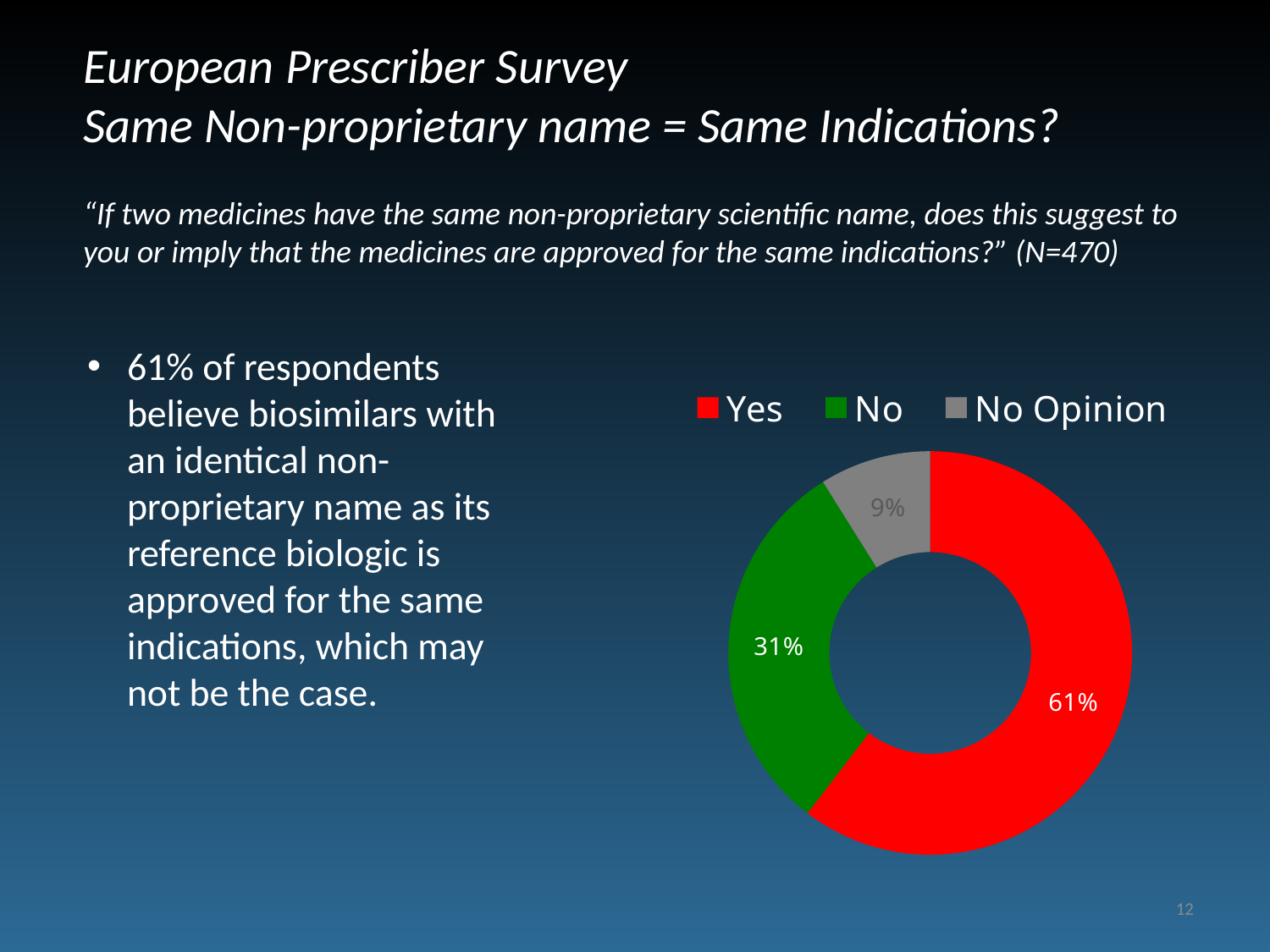
What type of chart is shown on the slide? Doughnut chart What is the difference in percentage points between the "No" and "No Opinion" shares? 22 Which is larger, the share for "No" or the share for "No Opinion"? No What is the difference in percentage points between the "Yes" and "No" shares? 30 What colour represents the "Yes" category in the chart? Red What percentage of respondents had "No Opinion" according to the chart? 9% Which response category has the smallest share in the chart? No Opinion What colour represents the "No Opinion" category in the chart? Grey What percentage of respondents answered "No" in the doughnut chart? 31% How many response categories are shown in the chart? 3 What percentage of respondents answered "Yes" in the doughnut chart? 61% Which response category has the largest share in the chart? Yes